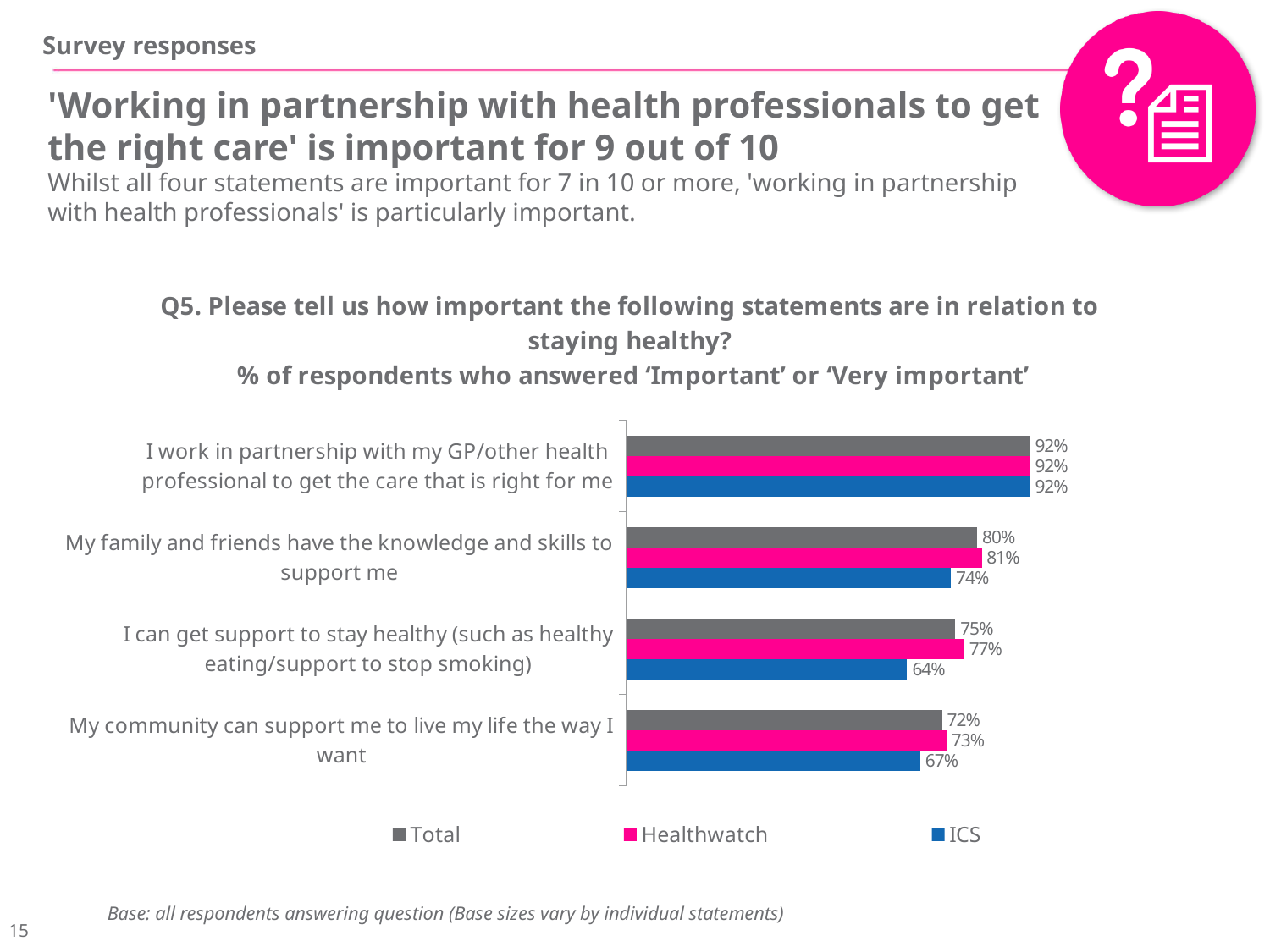
Which series is shown in pink in the chart? Healthwatch How many statements are shown on the chart? 4 What type of chart is shown on the slide? Bar chart Which statement has the highest Total value? I work in partnership with my GP/other health professional to get the care that is right for me What is the Healthwatch value for 'My family and friends have the knowledge and skills to support me'? 81% For 'My family and friends have the knowledge and skills to support me', which is larger: the Total value or the ICS value? Total What percentage of Total respondents rated 'I work in partnership with my GP/other health professional to get the care that is right for me' as important or very important? 92% Which statement has the lowest ICS value? I can get support to stay healthy (such as healthy eating/support to stop smoking) What is the difference between the Healthwatch and ICS values for 'I can get support to stay healthy (such as healthy eating/support to stop smoking)'? 13 percentage points What is the ICS value for 'My community can support me to live my life the way I want'? 67% How many series does the legend list? 3 What is the ICS value for 'I can get support to stay healthy (such as healthy eating/support to stop smoking)'? 64%